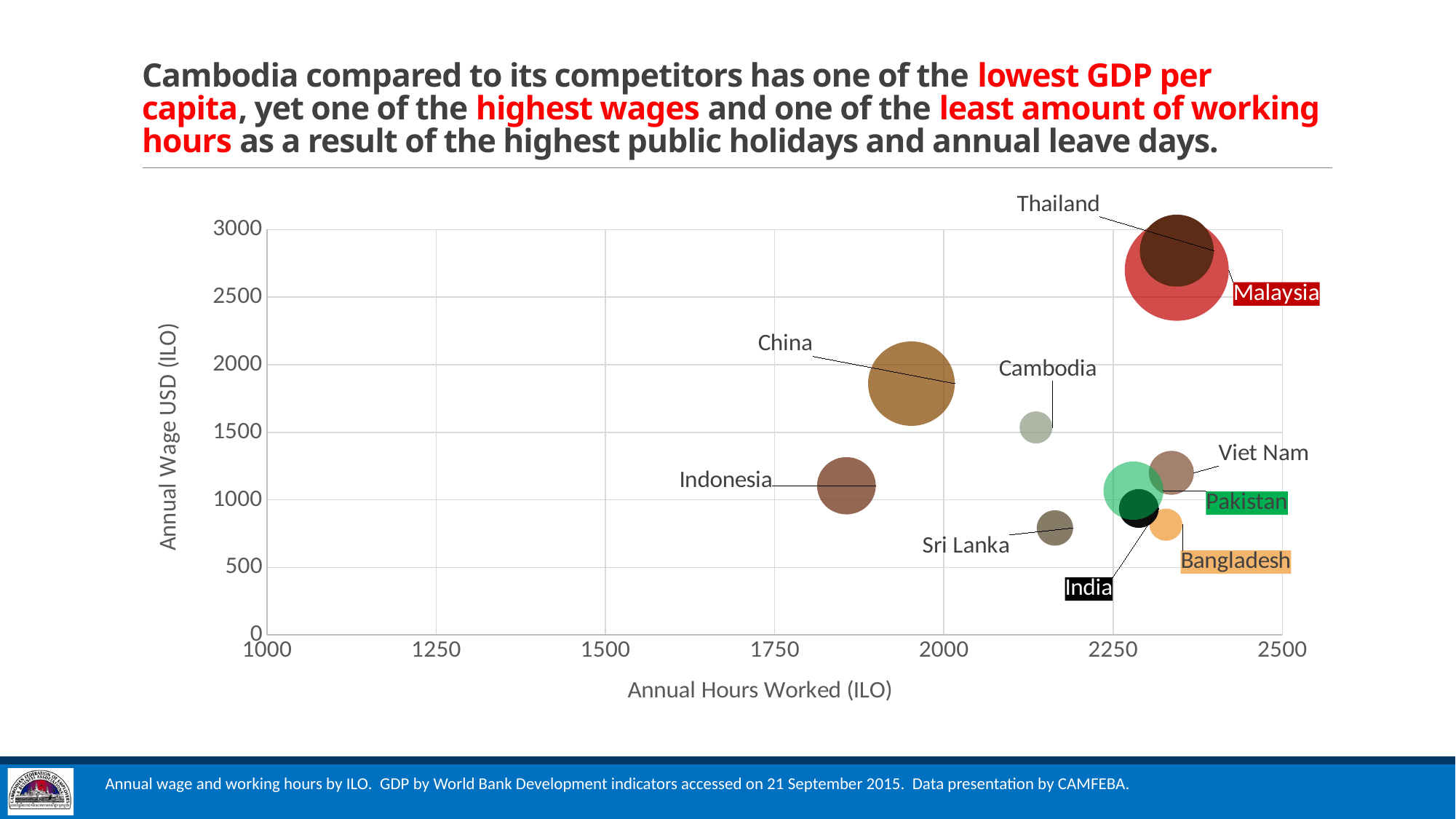
What is the label of the vertical axis? Annual Wage USD (ILO) What is the label of the horizontal axis? Annual Hours Worked (ILO) Which country has the highest annual wage on the chart? Thailand Which has the higher annual wage, China or Cambodia? China Are the annual hours worked for Viet Nam greater or less than 2250? greater Are the annual hours worked for Cambodia greater or less than 2250? less How many countries are plotted on the chart? 10 What kind of chart is shown on the slide? Bubble chart Is the annual wage for Bangladesh greater or less than 1000? less Which has more annual hours worked, Indonesia or Cambodia? Cambodia Which country has the fewest annual hours worked on the chart? Indonesia